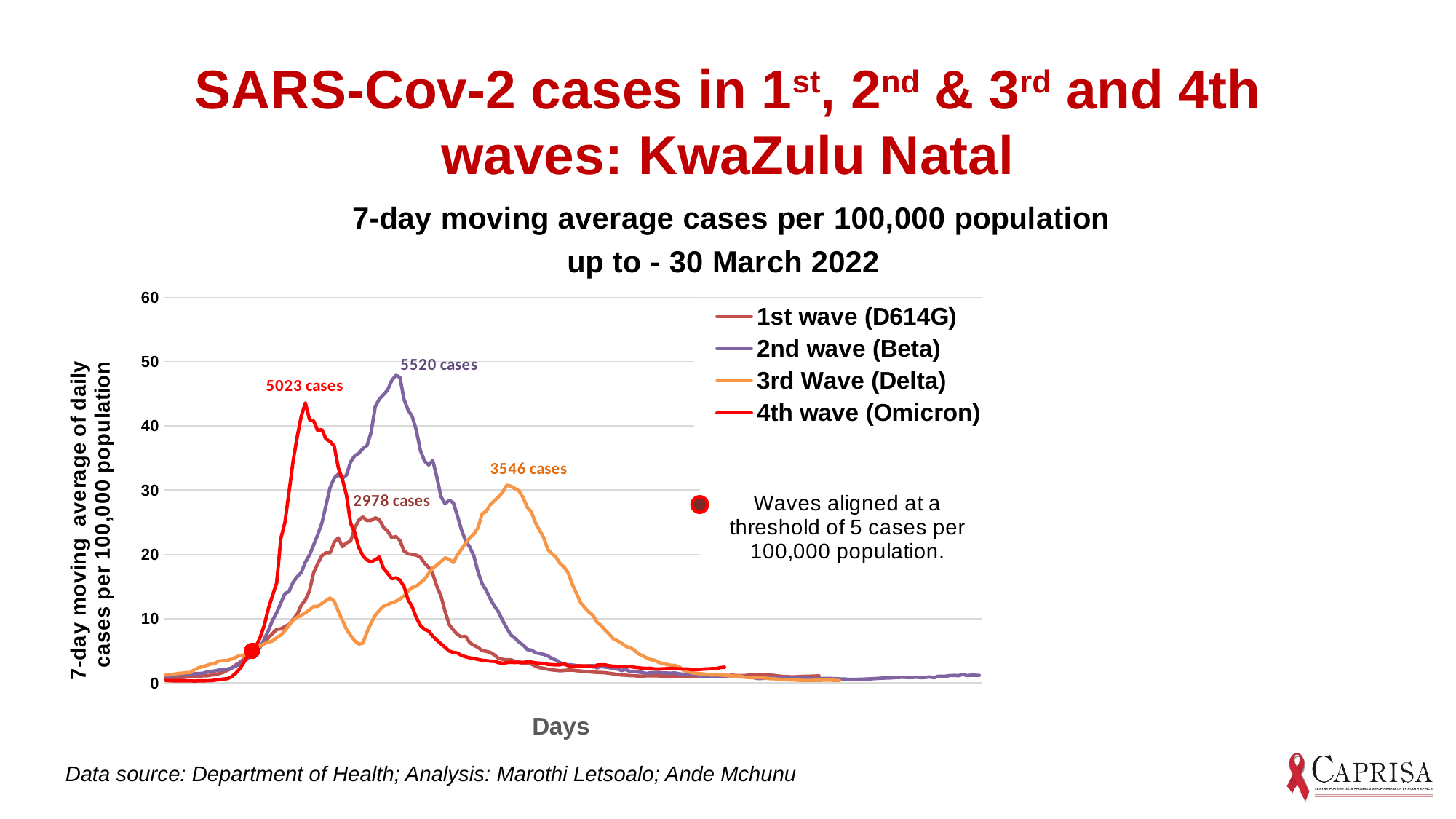
What is the difference between the annotated peak case counts of the 2nd wave (5520 cases) and the 4th wave (5023 cases)? 497 cases How many cases are annotated at the peak of the 1st wave (D614G)? 2978 cases How many series does the legend list? 4 Is the peak value of the 2nd wave (Beta) greater or less than 40 cases per 100,000 population? greater What kind of chart is shown on the slide? line chart Which variant is associated with the 3rd Wave in the legend? Delta How many cases are annotated at the peak of the 4th wave (Omicron)? 5023 cases Which wave has the highest peak in the chart? 2nd wave (Beta) How many cases are annotated at the peak of the 2nd wave (Beta)? 5520 cases Is the peak value of the 1st wave (D614G) greater or less than 30 cases per 100,000 population? less Which wave has the lowest peak in the chart? 1st wave (D614G) How many cases are annotated at the peak of the 3rd Wave (Delta)? 3546 cases